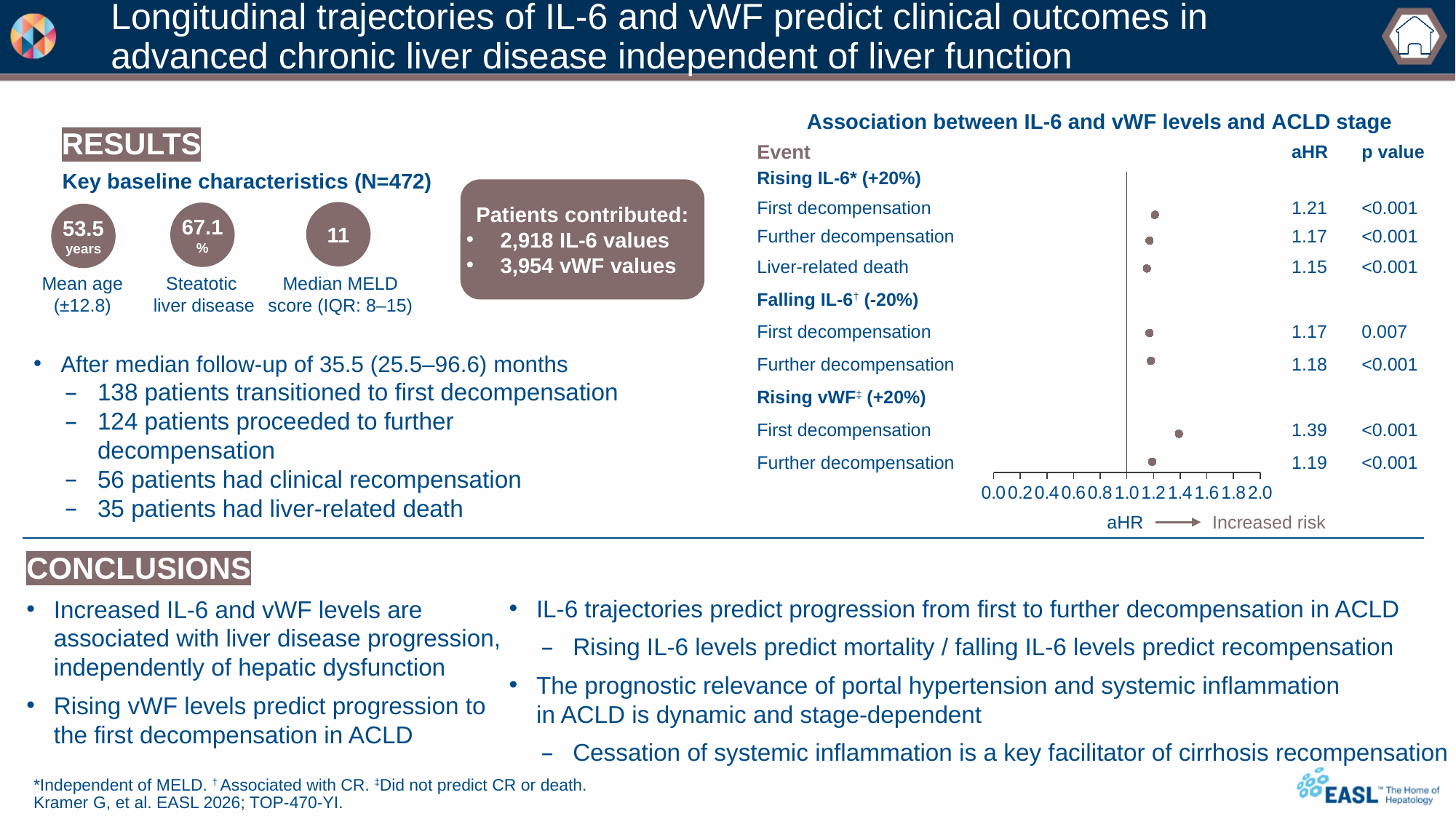
How many aHR points are plotted in the chart? 7 Which event and exposure has the highest aHR in the plot? First decompensation with rising vWF (+20%) What is the aHR for first decompensation with rising IL-6 (+20%)? 1.21 What is the title of the chart? Association between IL-6 and vWF levels and ACLD stage What is the maximum value shown on the aHR axis? 2.0 Is the aHR for further decompensation with falling IL-6 (-20%) greater or less than 1.0? greater Which event and exposure has the lowest aHR in the plot? Liver-related death with rising IL-6 (+20%) What is the aHR for first decompensation with rising vWF (+20%)? 1.39 What is the difference between the aHR for first decompensation and further decompensation with rising vWF (+20%)? 0.20 What is the aHR for liver-related death with rising IL-6 (+20%)? 1.15 What is the p value for first decompensation with falling IL-6 (-20%)? 0.007 Which has a larger aHR: first decompensation with rising IL-6 or first decompensation with rising vWF? First decompensation with rising vWF